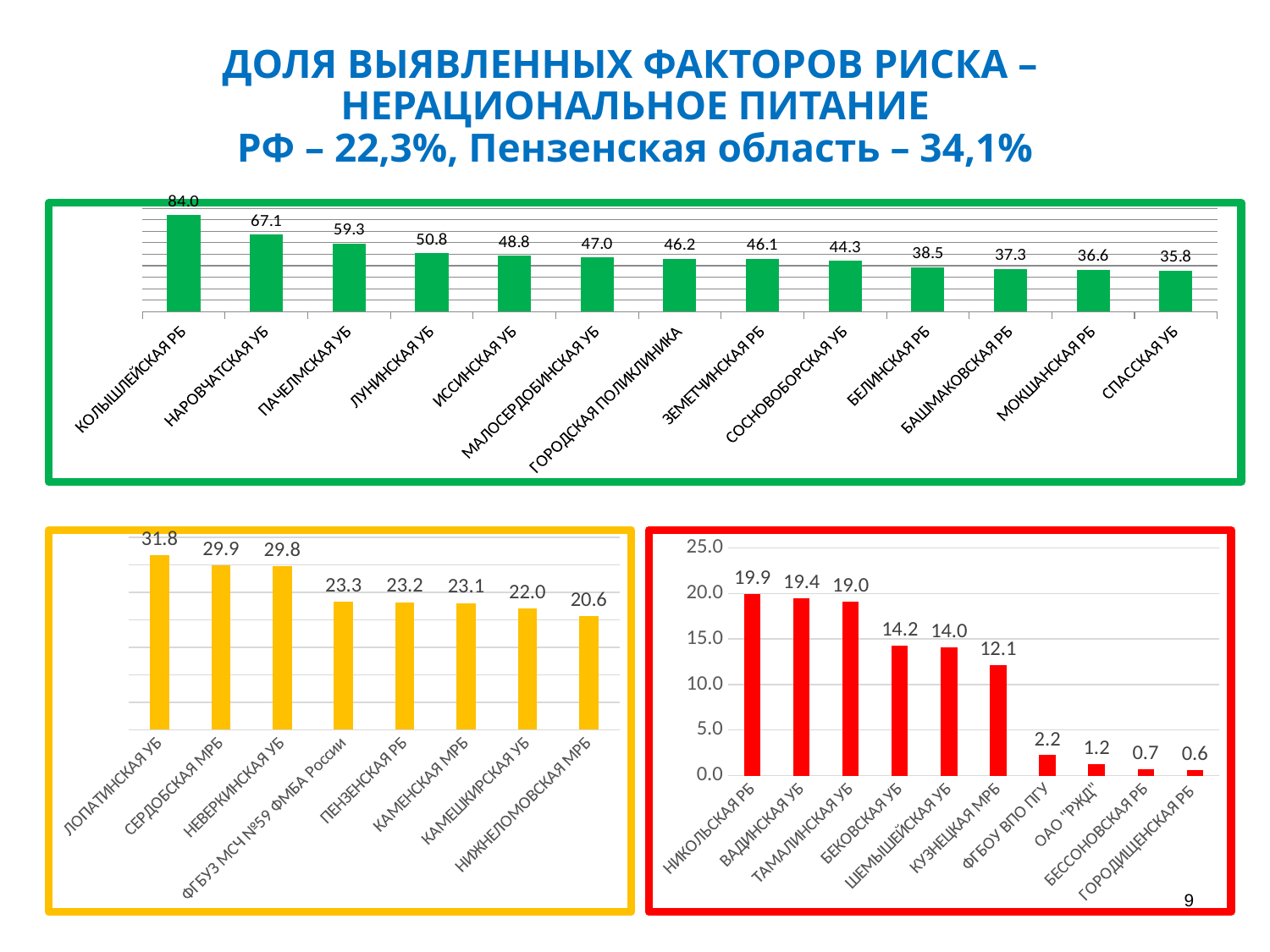
In the bottom-right chart (red border), what is the value for КУЗНЕЦКАЯ МРБ? 12.1 In the top chart (green border), what is the difference between the values for НАРОВЧАТСКАЯ УБ and ПАЧЕЛМСКАЯ УБ? 7.8 In the top chart (green border), what is the value for КОЛЫШЛЕЙСКАЯ РБ? 84.0 In the bottom-left chart (yellow border), how many categories are shown? 8 In the top chart (green border), which category has the lowest value? СПАССКАЯ УБ In the top chart (green border), do the values rise or fall from left to right? fall In the bottom-right chart (red border), what is the difference between the values for НИКОЛЬСКАЯ РБ and ГОРОДИЩЕНСКАЯ РБ? 19.3 In the bottom-left chart (yellow border), which category has the highest value? ЛОПАТИНСКАЯ УБ In the top chart (green border), how many categories are shown? 13 What type of chart is the bottom-right chart (red border)? bar chart In the bottom-left chart (yellow border), what is the value for ПЕНЗЕНСКАЯ РБ? 23.2 In the bottom-right chart (red border), which is larger, the value for БЕКОВСКАЯ УБ or the value for ФГБОУ ВПО ПГУ? БЕКОВСКАЯ УБ